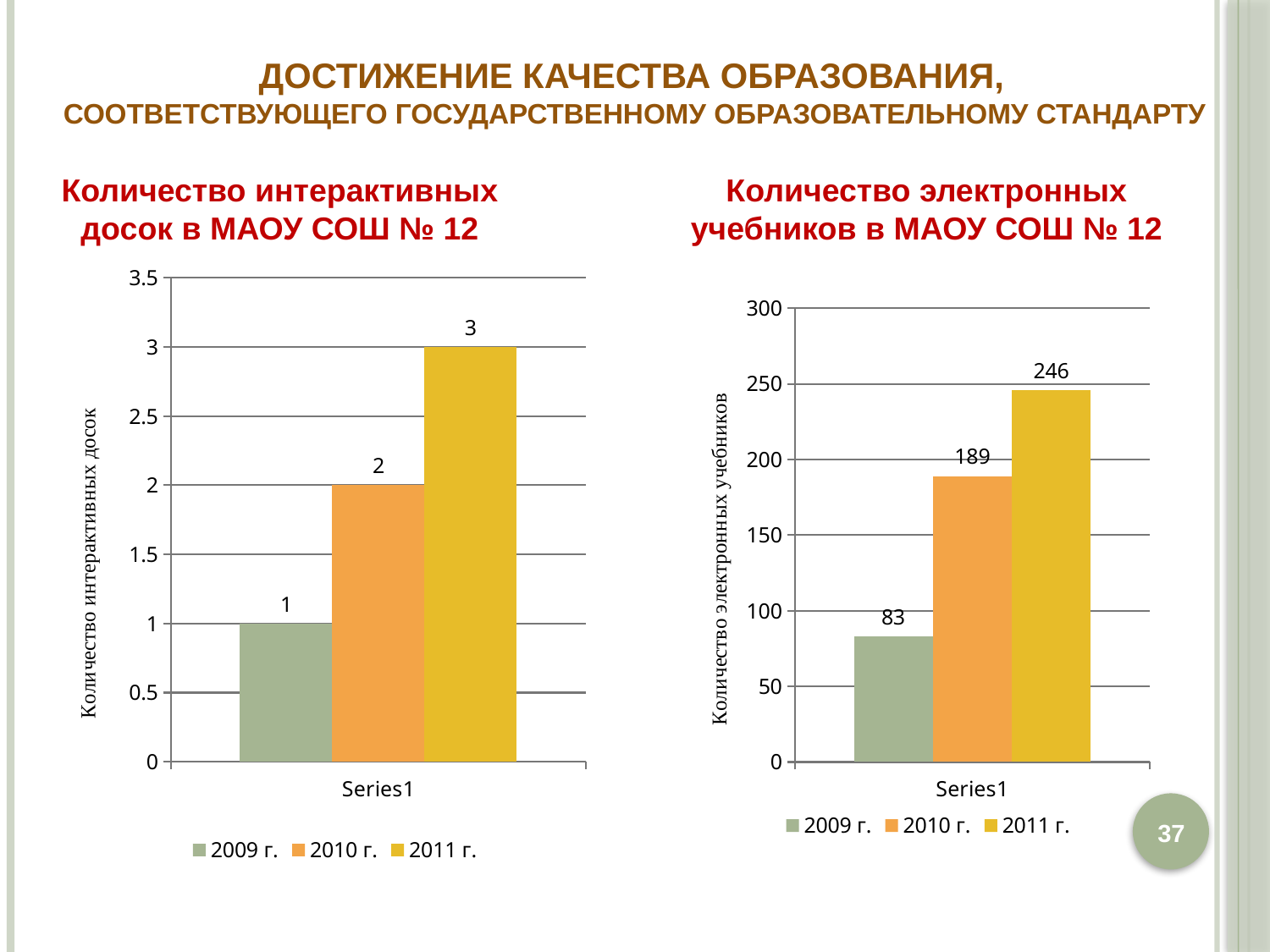
How many series does the legend of the right chart (Количество электронных учебников в МАОУ СОШ № 12) list? 3 What kind of chart is the left chart (Количество интерактивных досок в МАОУ СОШ № 12)? bar chart In the left chart (Количество интерактивных досок в МАОУ СОШ № 12), what is the difference between the values for 2010 г. and 2009 г.? 1 In the left chart (Количество интерактивных досок в МАОУ СОШ № 12), what is the value for 2009 г.? 1 In the right chart (Количество электронных учебников в МАОУ СОШ № 12), which year has the lowest value? 2009 г. In the right chart (Количество электронных учебников в МАОУ СОШ № 12), is the value for 2010 г. greater or less than 150? greater In the right chart (Количество электронных учебников в МАОУ СОШ № 12), what is the value for 2011 г.? 246 In the left chart (Количество интерактивных досок в МАОУ СОШ № 12), what is the value for 2011 г.? 3 In the left chart (Количество интерактивных досок в МАОУ СОШ № 12), which year has the highest value? 2011 г. In the right chart (Количество электронных учебников в МАОУ СОШ № 12), do the values rise or fall from 2009 г. to 2011 г.? rise In the right chart (Количество электронных учебников в МАОУ СОШ № 12), what is the difference between the values for 2011 г. and 2009 г.? 163 In the right chart (Количество электронных учебников в МАОУ СОШ № 12), what is the value for 2010 г.? 189